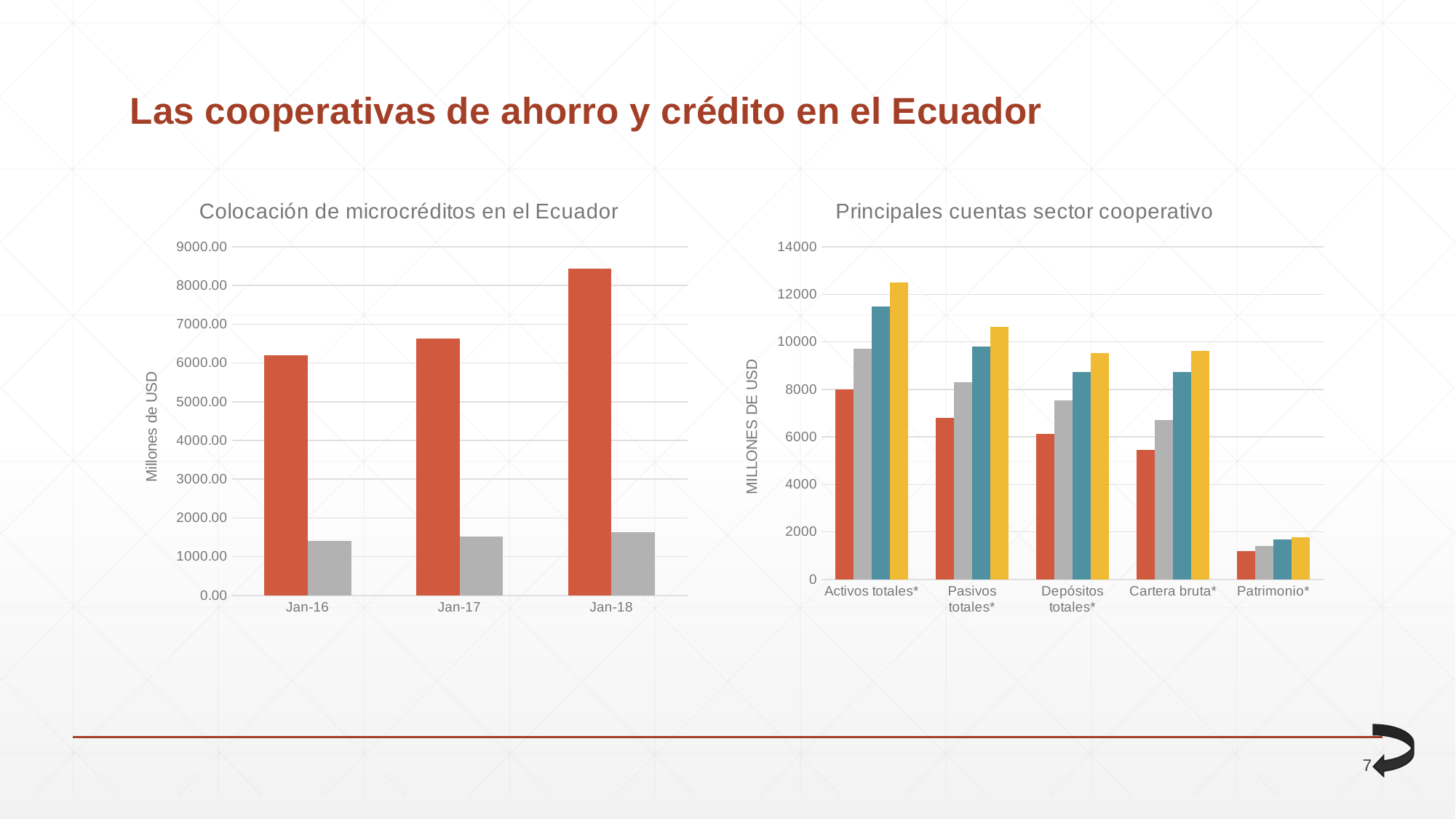
In the 'Principales cuentas sector cooperativo' chart, which is larger: the red bar for Pasivos totales* or the red bar for Cartera bruta*? Pasivos totales* What kind of chart is the 'Colocación de microcréditos en el Ecuador' chart? bar chart In the 'Colocación de microcréditos en el Ecuador' chart, is the red bar for Jan-18 greater or less than 8000.00? greater How many categories are shown on the x axis of the 'Principales cuentas sector cooperativo' chart? 5 In the 'Colocación de microcréditos en el Ecuador' chart, do the red bars rise or fall from Jan-16 to Jan-18? rise In the 'Colocación de microcréditos en el Ecuador' chart, is the gray bar for Jan-16 greater or less than 2000.00? less In the 'Colocación de microcréditos en el Ecuador' chart, which category has the tallest red bar? Jan-18 In the 'Principales cuentas sector cooperativo' chart, is the yellow bar for Activos totales* greater or less than 12000? greater How many categories are shown on the x axis of the 'Colocación de microcréditos en el Ecuador' chart? 3 In the 'Principales cuentas sector cooperativo' chart, which category has the lowest bars overall? Patrimonio* What is the y-axis label of the 'Colocación de microcréditos en el Ecuador' chart? Millones de USD